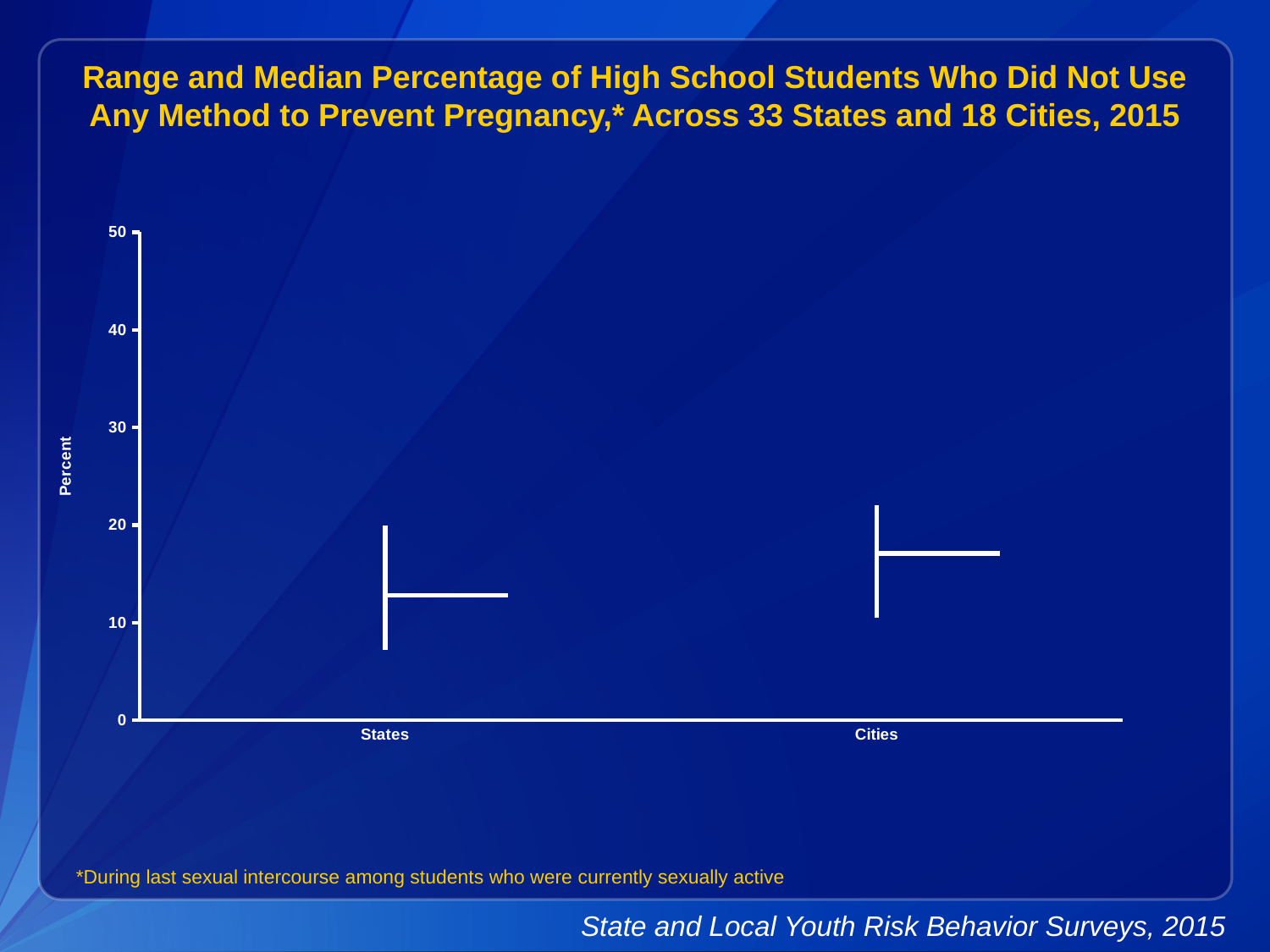
Which category has the lower median percentage? States Is the top of the range for Cities greater or less than 20? greater What is the highest value shown on the y axis? 50 Is the median value for States greater or less than 10? greater What is the label on the y axis? Percent Which has the higher median percentage, States or Cities? Cities Is the median value for Cities greater or less than 20? less How many categories are shown on the x axis? 2